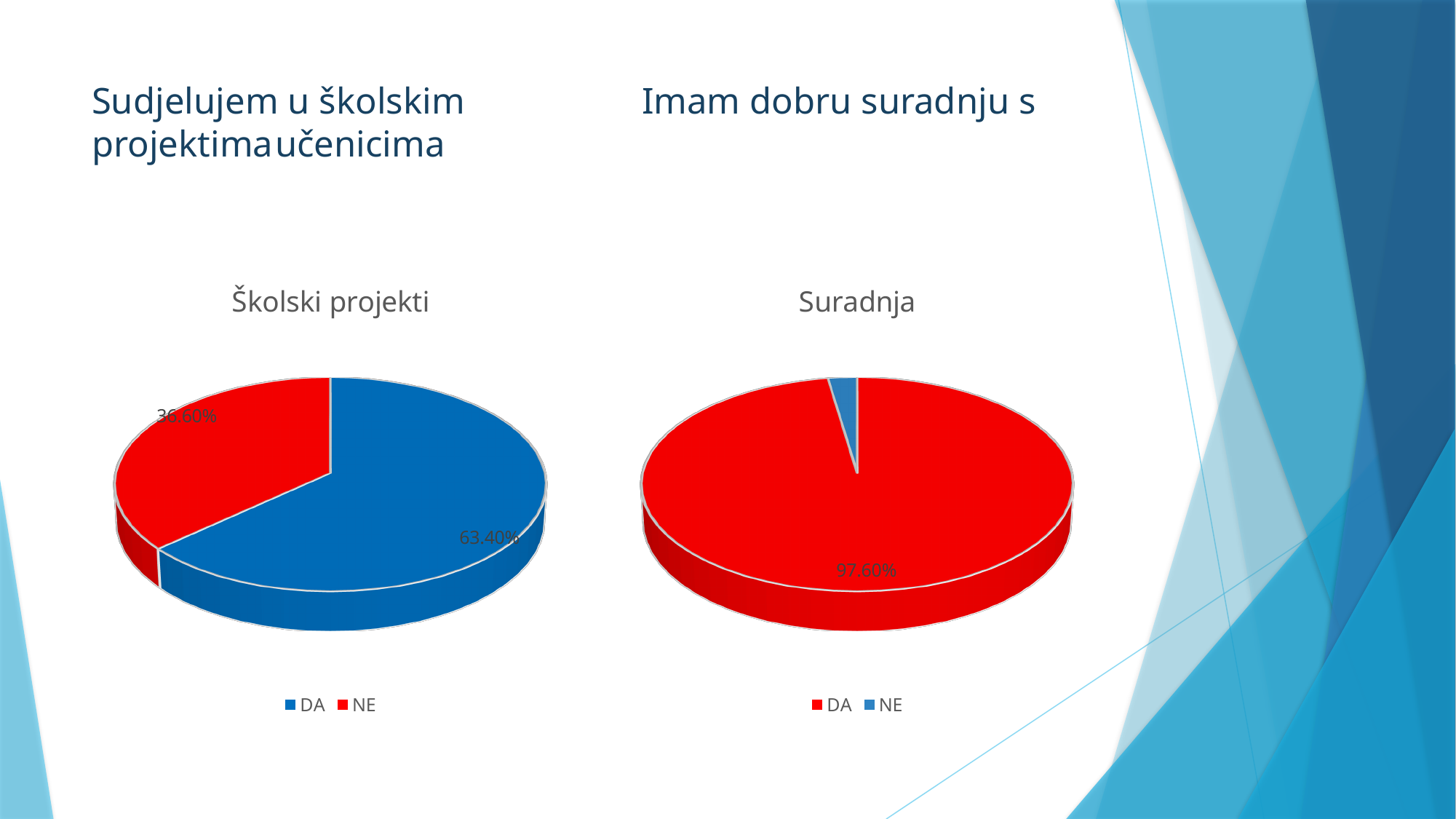
In the 'Školski projekti' chart, what percentage is shown for DA? 63.40% In the 'Suradnja' chart, which is larger, DA or NE? DA In the 'Suradnja' chart, which category has the smallest share? NE What is the title of the chart on the left side of the slide? Školski projekti How many entries does the legend of the 'Suradnja' chart list? 2 What colour is the DA slice in the 'Suradnja' chart? Red In the 'Školski projekti' chart, which category has the largest share? DA What type of chart is the 'Suradnja' chart? Pie chart In the 'Školski projekti' chart, what is the difference between the DA and NE shares? 26.80% How many slices does the 'Školski projekti' chart have? 2 In the 'Školski projekti' chart, what percentage is shown for NE? 36.60% In the 'Suradnja' chart, what percentage is shown for DA? 97.60%